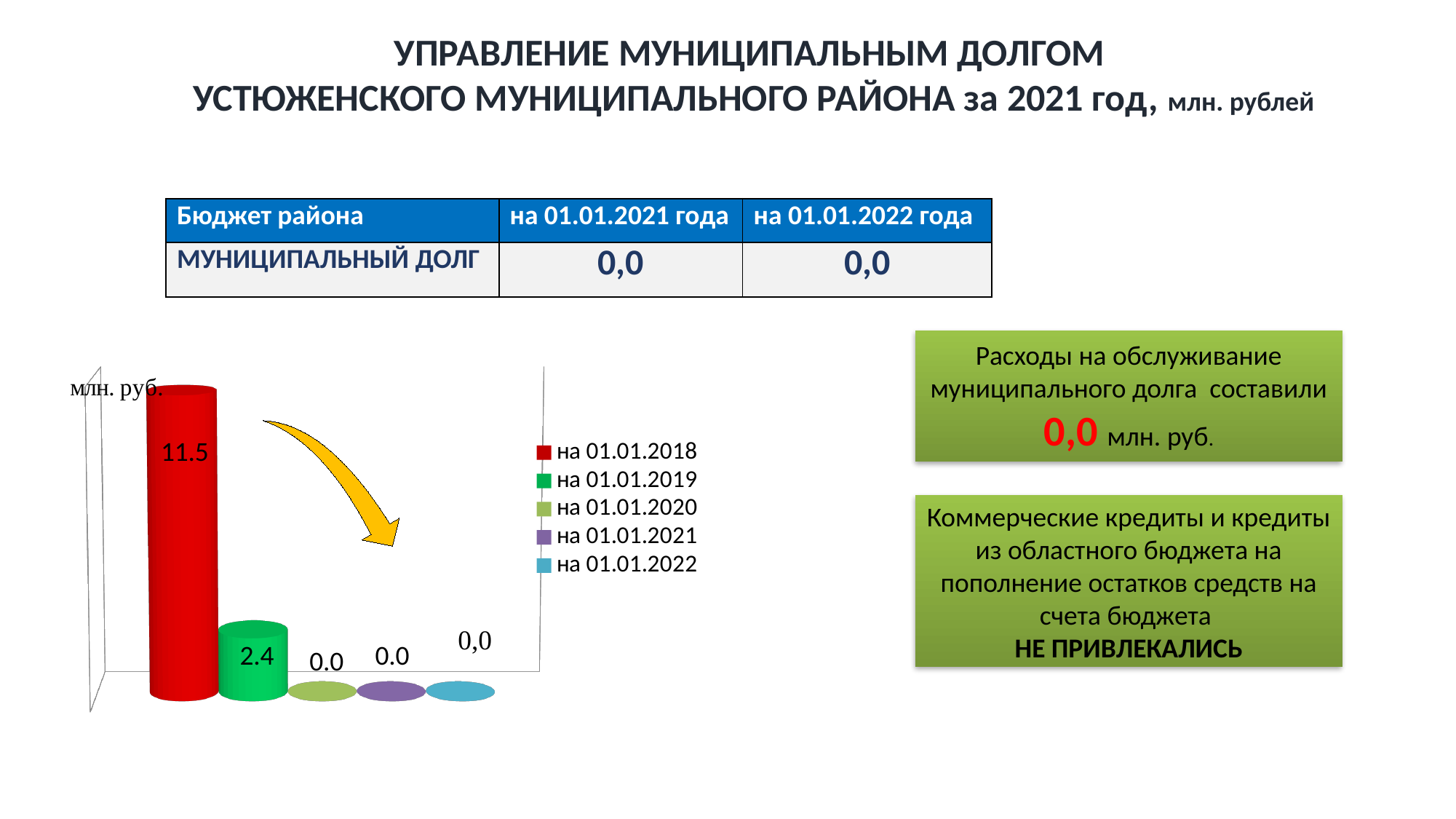
Which series has the highest value in the chart? на 01.01.2018 How many bars are plotted in the chart? 5 Which is larger: the value for на 01.01.2018 or the value for на 01.01.2019? на 01.01.2018 What is the difference between the values for на 01.01.2018 and на 01.01.2019? 9.1 What type of chart is shown on the slide? bar chart Do the values in the chart rise or fall from на 01.01.2018 to на 01.01.2022? fall What is the value for на 01.01.2019 in the chart? 2.4 What colour is the bar for на 01.01.2018 in the chart? red What is the value for на 01.01.2022 in the chart? 0,0 What is the value for на 01.01.2018 in the chart? 11.5 What is the value for на 01.01.2020 in the chart? 0.0 How many series does the chart legend list? 5